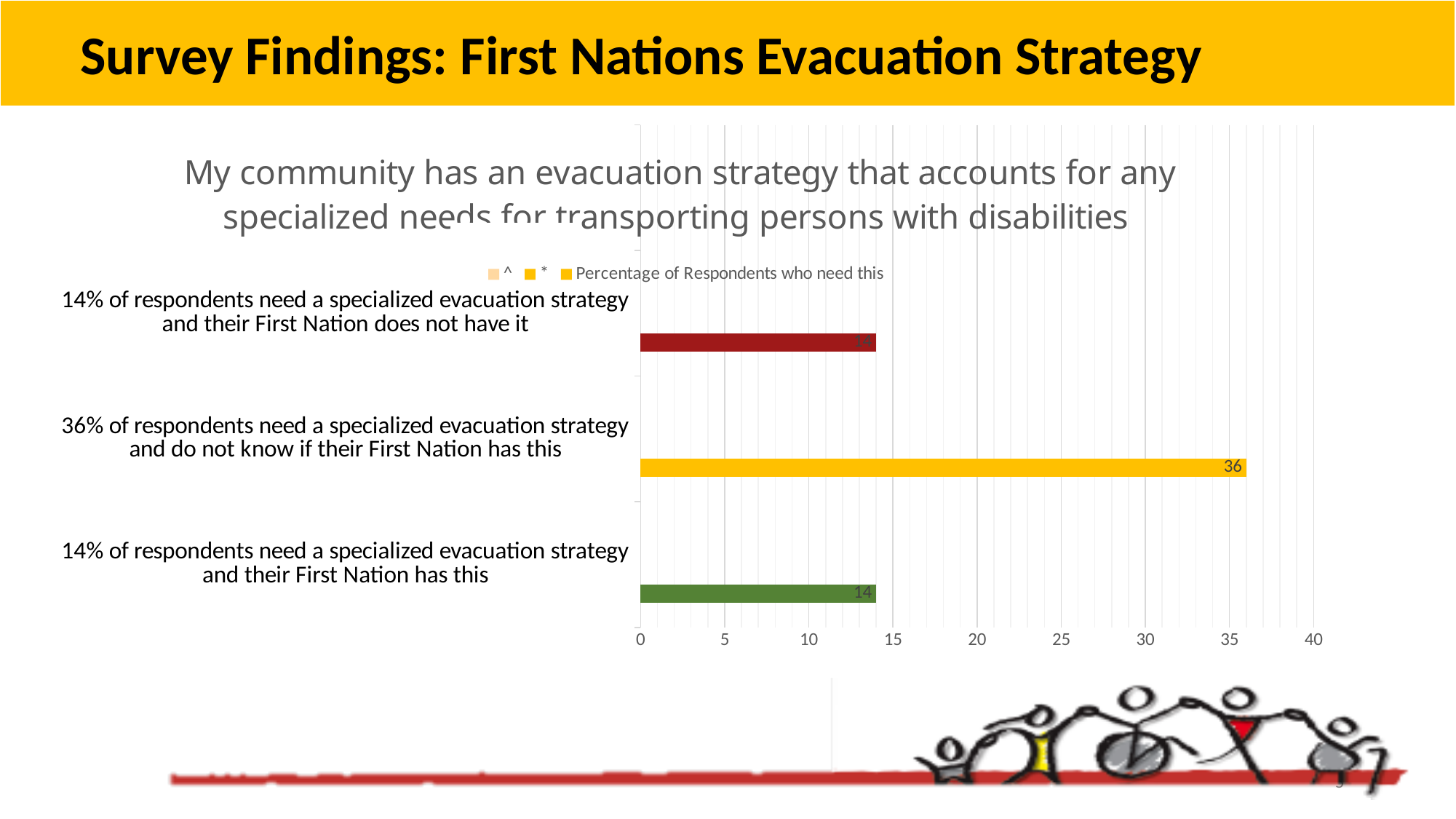
What is the value of the bar for respondents who need a specialized evacuation strategy and do not know if their First Nation has this? 36 What is the value of the bar for respondents who need a specialized evacuation strategy and their First Nation has this? 14 How many bars are plotted in the chart? 3 Which is larger: the value for respondents who do not know if their First Nation has this, or the value for respondents whose First Nation does not have it? respondents who do not know if their First Nation has this What is the difference between the value for respondents who do not know if their First Nation has this and the value for respondents whose First Nation has this? 22 Is the value for respondents who do not know if their First Nation has this greater or less than 30? greater What is the highest value shown on the horizontal axis of the chart? 40 What kind of chart is shown on the slide? bar chart What colour is the bar for respondents who do not know if their First Nation has this? yellow How many entries does the chart legend list? 3 What is the value of the bar for respondents who need a specialized evacuation strategy and their First Nation does not have it? 14 Which category has the highest value in the chart? 36% of respondents need a specialized evacuation strategy and do not know if their First Nation has this